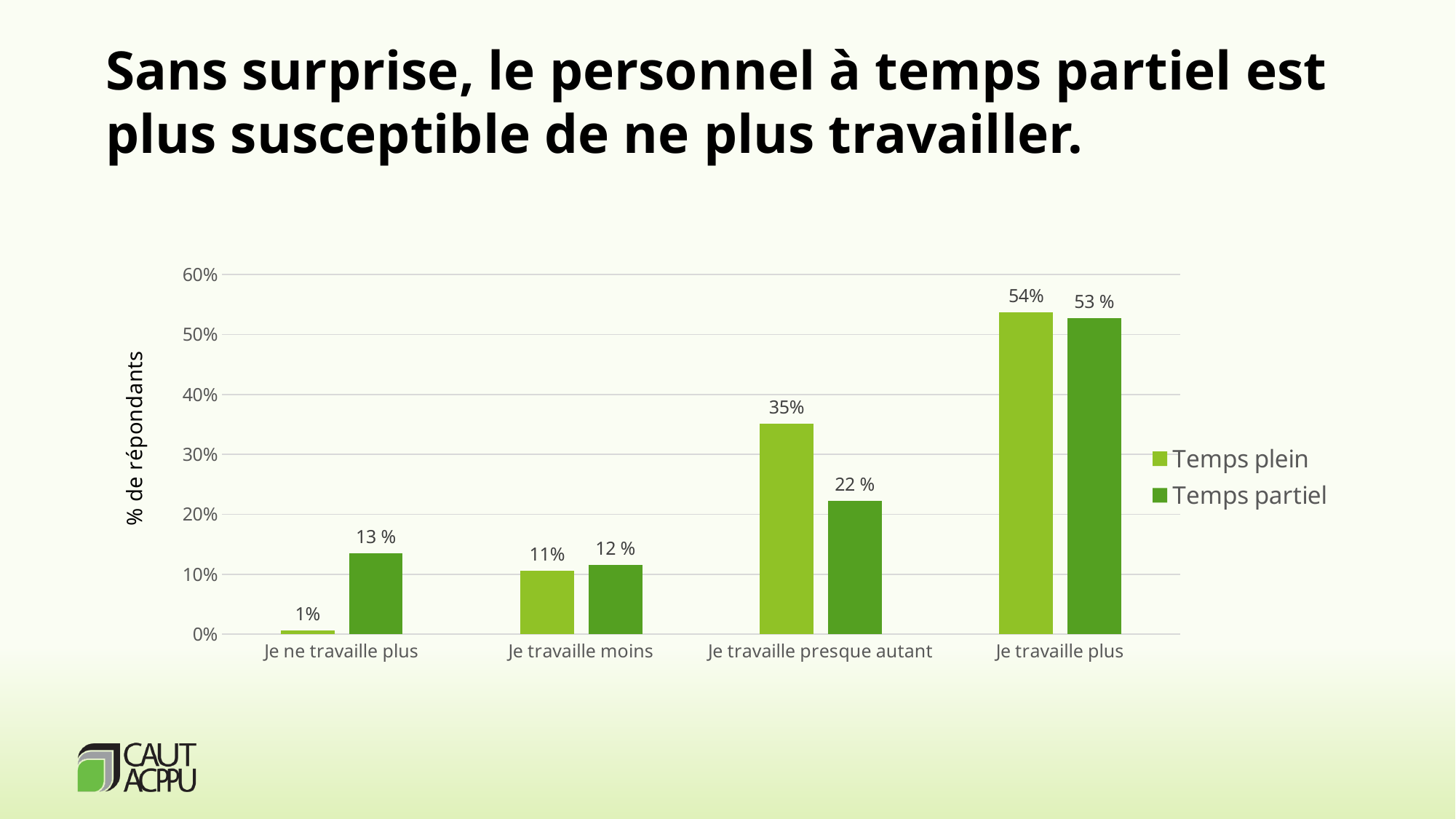
Which category has the highest value for Temps plein? Je travaille plus What kind of chart is shown on the slide? Bar chart What is the value for Temps partiel in the 'Je travaille presque autant' category? 22 % What is the value for Temps plein in the 'Je travaille plus' category? 54% What is the difference between Temps plein and Temps partiel in the 'Je travaille presque autant' category? 13 percentage points How many series does the legend list? 2 How many categories are shown on the x axis? 4 Which category has the lowest value for Temps plein? Je ne travaille plus In the 'Je ne travaille plus' category, which series has the larger value, Temps plein or Temps partiel? Temps partiel What is the value for Temps plein in the 'Je ne travaille plus' category? 1% What is the value for Temps partiel in the 'Je ne travaille plus' category? 13 % What is the label of the y axis? % de répondants